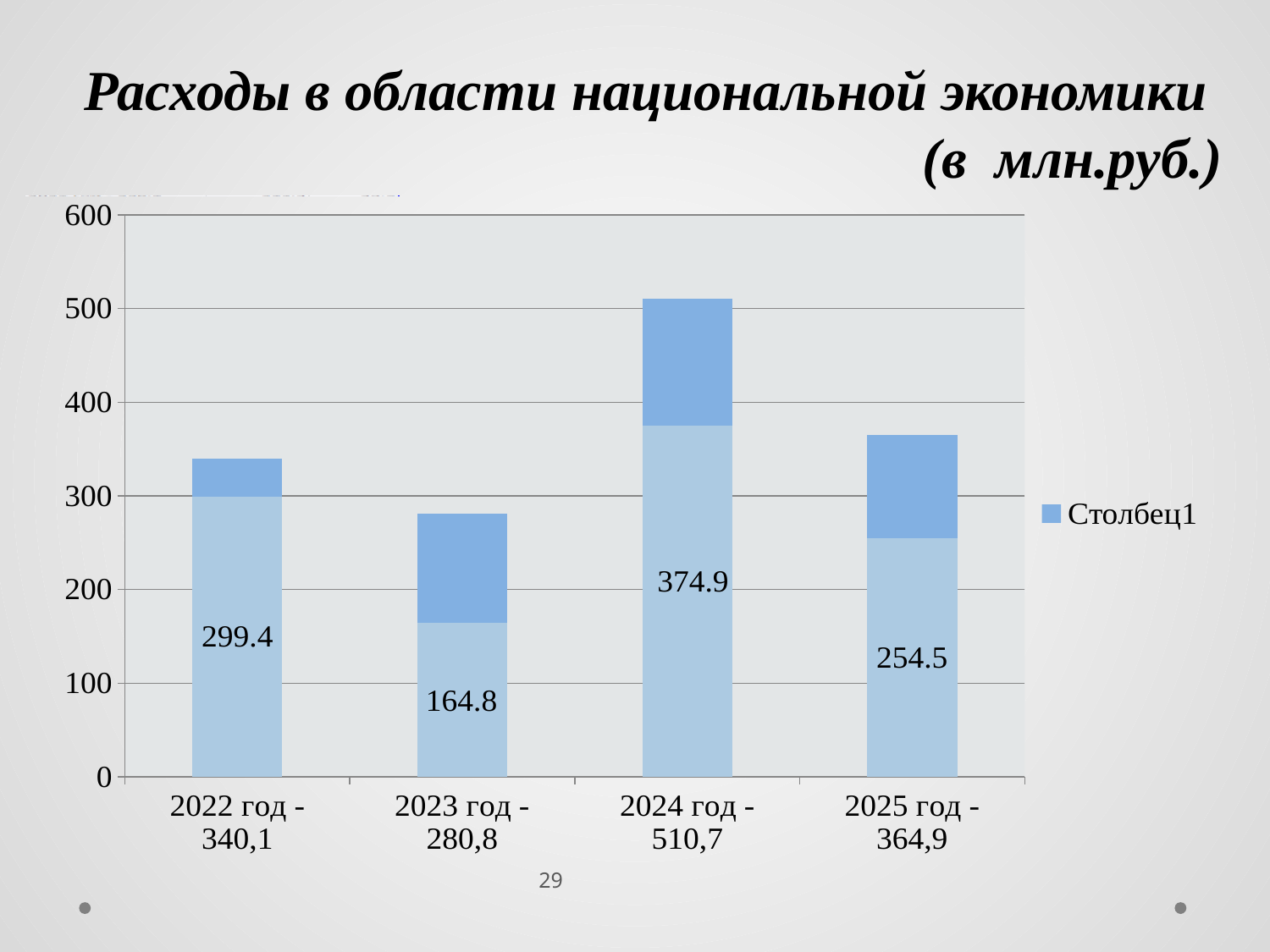
Which year has the highest labelled lower-segment value? 2024 год Which year has the lowest labelled lower-segment value? 2023 год What is the labelled value of the lower segment of the bar for 2023 год? 164.8 How many series does the legend list? 1 Which is larger, the labelled lower-segment value for 2022 год or for 2025 год? 2022 год What type of chart is shown on the slide? Stacked bar chart Is the total height of the bar for 2024 год greater or less than 500? greater What is the labelled value of the lower segment of the bar for 2022 год? 299.4 What is the labelled value of the lower segment of the bar for 2025 год? 254.5 What is the difference between the labelled lower-segment values for 2024 год and 2023 год? 210.1 What is the labelled value of the lower segment of the bar for 2024 год? 374.9 How many bars (years) are shown in the chart? 4